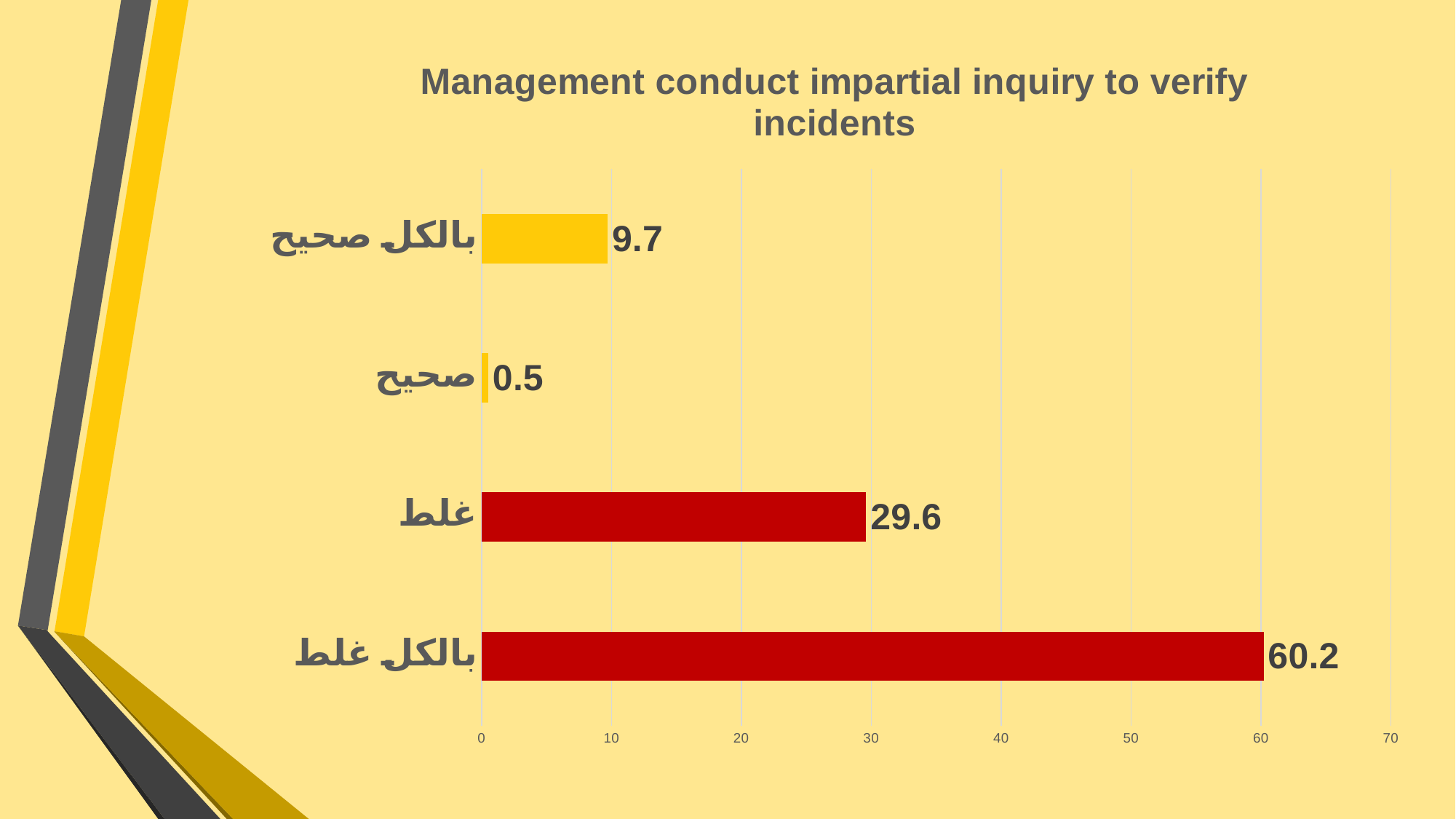
Is the value for بالكل غلط greater or less than 50? greater What is the value for غلط? 29.6 What is the value for بالكل غلط? 60.2 What is the title of the chart? Management conduct impartial inquiry to verify incidents Which category has the highest value? بالكل غلط What is the value for صحيح? 0.5 What is the difference between the values for بالكل غلط and غلط? 30.6 What is the value for بالكل صحيح? 9.7 Which is larger, the value for بالكل صحيح or the value for غلط? غلط What kind of chart is shown on the slide? bar chart Which category has the lowest value? صحيح How many categories are shown in the chart? 4